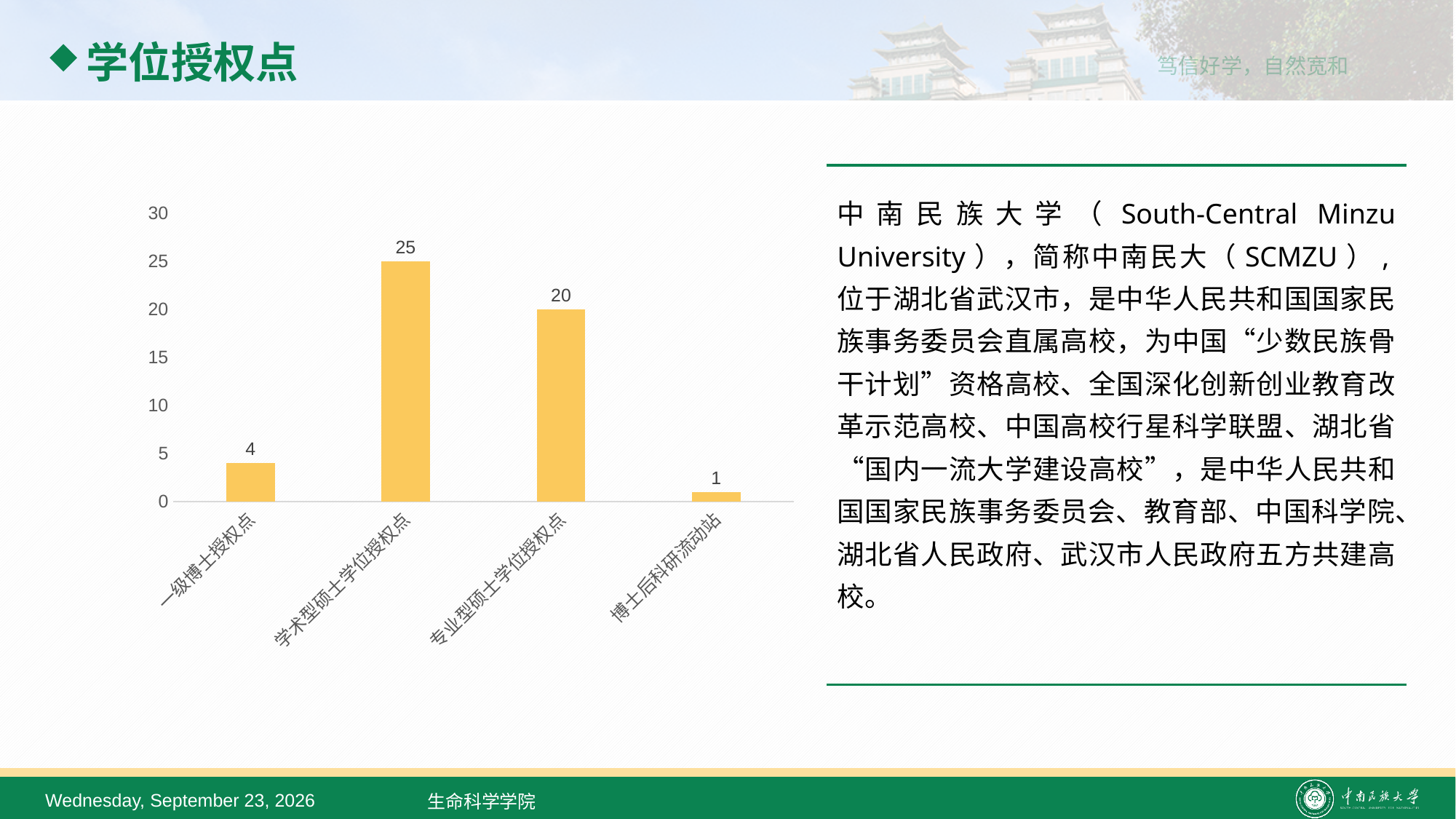
Which is larger, the value for 一级博士授权点 or the value for 博士后科研流动站? 一级博士授权点 What is the value for 博士后科研流动站? 1 What colour are the bars in the chart? yellow What is the value for 学术型硕士学位授权点? 25 Which category has the lowest value? 博士后科研流动站 What is the difference between the values for 学术型硕士学位授权点 and 专业型硕士学位授权点? 5 Is the value for 专业型硕士学位授权点 greater or less than 15? greater Which category has the highest value? 学术型硕士学位授权点 What is the value for 一级博士授权点? 4 What kind of chart is shown on the slide? bar chart How many categories are shown on the chart? 4 What is the value for 专业型硕士学位授权点? 20